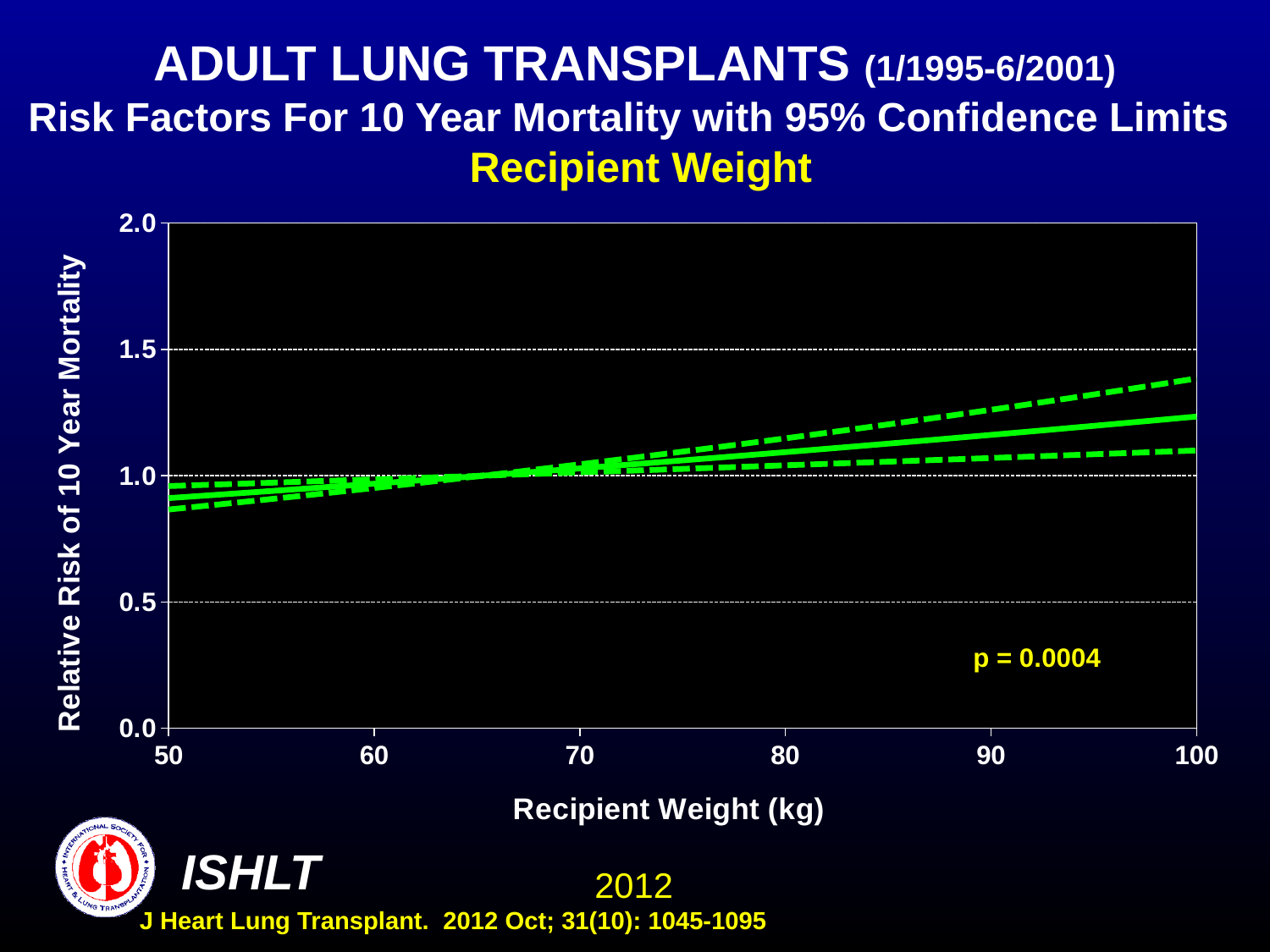
What kind of chart is shown on the slide? line chart At which end of the recipient weight axis is the relative risk of 10 year mortality highest? 100 kg Is the upper 95% confidence limit at a recipient weight of 100 kg greater or less than 1.5? less Which recipient weight has the larger relative risk of 10 year mortality, 50 kg or 100 kg? 100 kg Is the relative risk for a recipient weight of 100 kg greater or less than 1.5? less Is the relative risk for a recipient weight of 100 kg greater or less than 1.0? greater How many lines are plotted on the chart (including the confidence limit lines)? 3 Does the relative risk of 10 year mortality rise or fall as recipient weight increases from 50 to 100 kg? rise What is the label of the x axis? Recipient Weight (kg) What p-value is shown on the chart? p = 0.0004